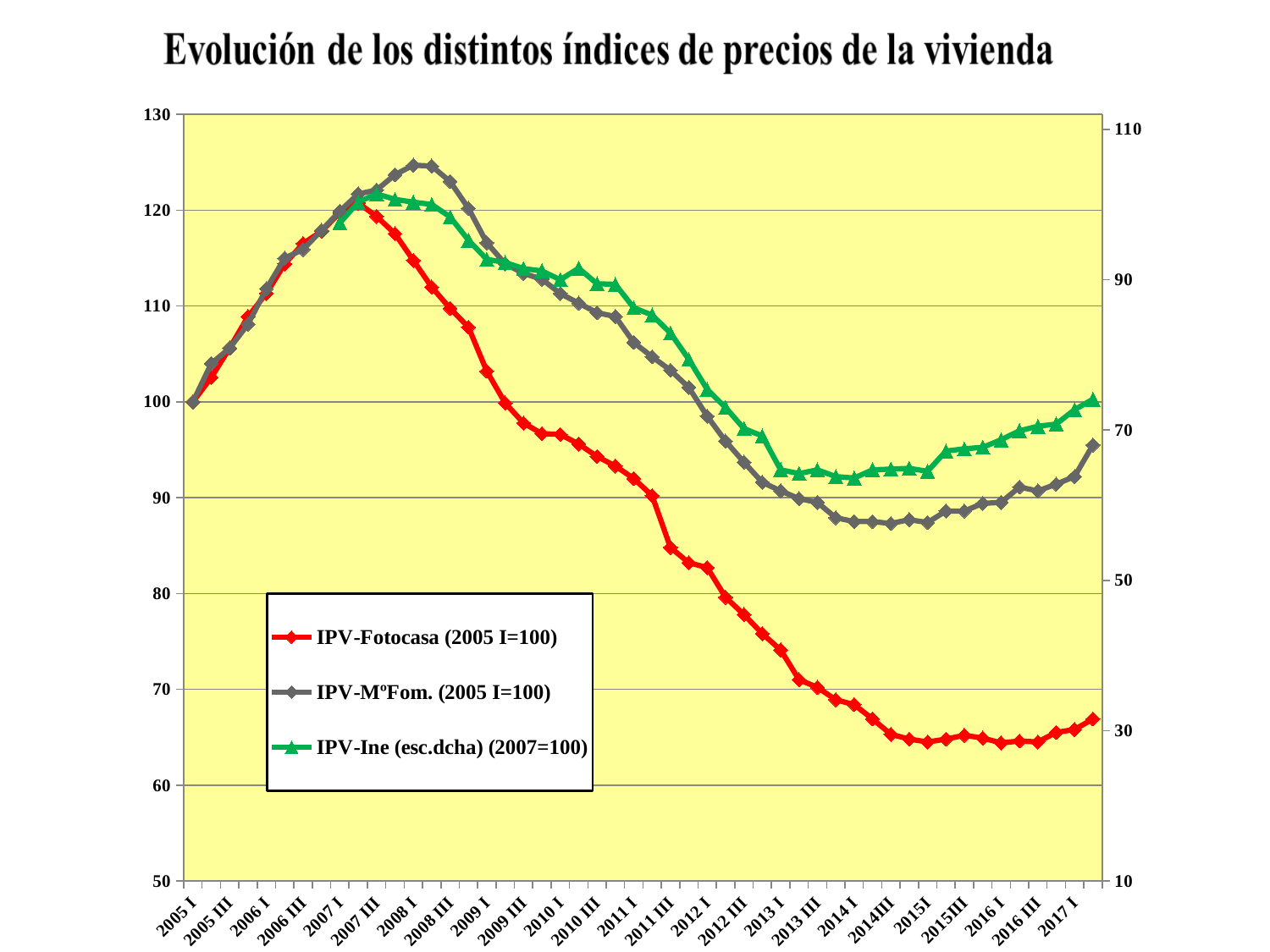
Is the value for IPV-Ine (right axis) at 2013 I greater or less than 70? less What is the value of IPV-Fotocasa at 2005 I? 100 Is the value for IPV-Fotocasa at 2015 I greater or less than 70? less How many series does the legend list? 3 What kind of chart is shown on the slide? line chart What is the title of the chart? Evolución de los distintos índices de precios de la vivienda Does the IPV-Fotocasa series rise or fall between 2007 III and 2015 I? fall Which series is plotted against the right-hand axis according to the legend? IPV-Ine (esc.dcha) (2007=100) Which series reaches the highest peak on the left axis, IPV-Fotocasa or IPV-MºFom.? IPV-MºFom. Is the value for IPV-MºFom. at 2008 I greater or less than 120? greater At 2017 I, which is larger: IPV-Fotocasa or IPV-MºFom.? IPV-MºFom. Which series has the lowest value at 2017 I on the left axis? IPV-Fotocasa